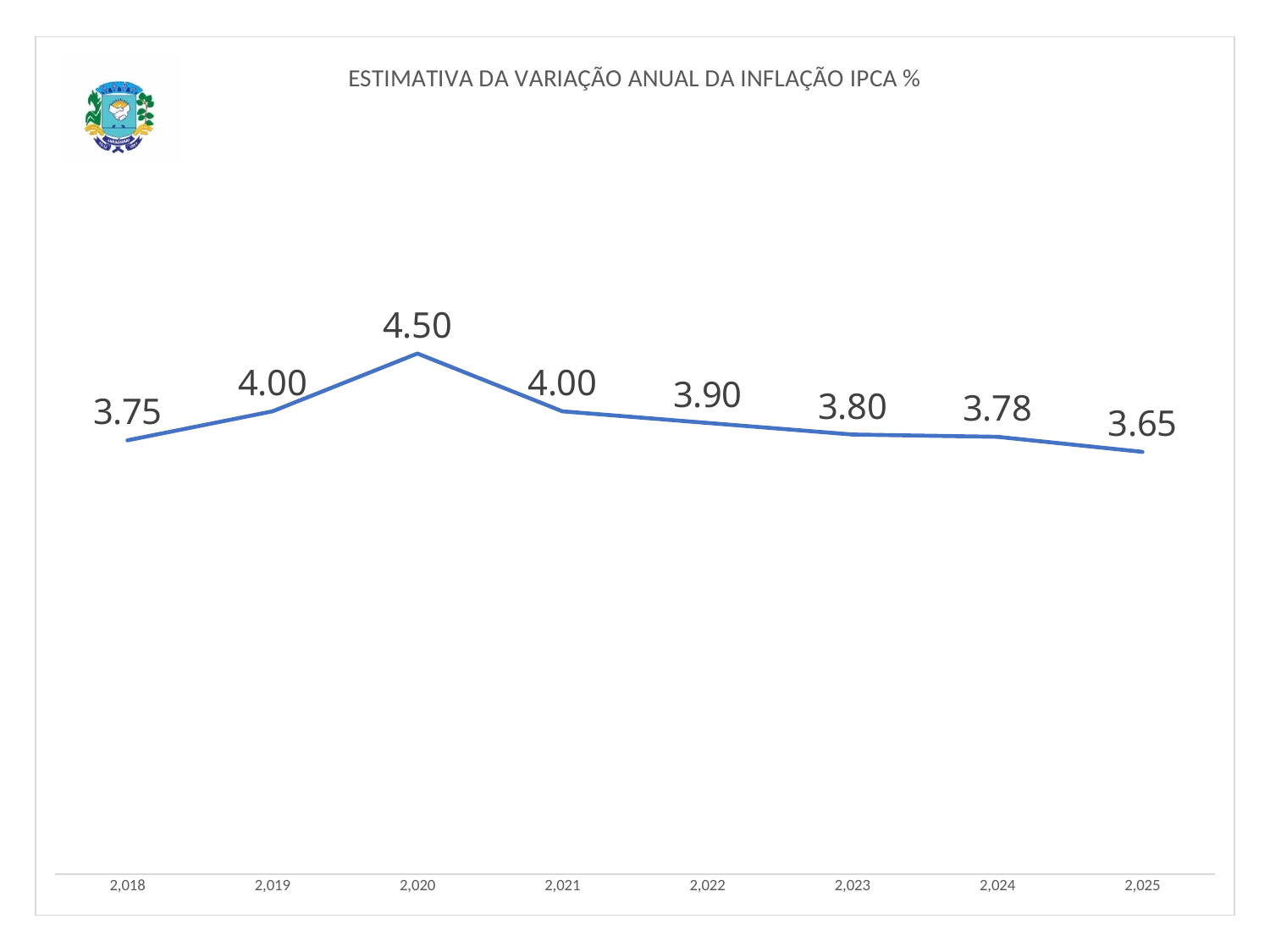
What is the estimated IPCA inflation value for 2,018? 3.75 What is the difference between the values for 2,019 and 2,018? 0.25 What is the difference between the values for 2,020 and 2,025? 0.85 How many years are plotted on the chart? 8 Do the values rise or fall from 2,020 to 2,025? Fall What is the estimated IPCA inflation value for 2,020? 4.50 Which year has the lowest estimated IPCA inflation value? 2,025 What kind of chart is shown on the slide? Line chart What is the estimated IPCA inflation value for 2,025? 3.65 Which year has a larger value, 2,022 or 2,023? 2,022 What is the estimated IPCA inflation value for 2,024? 3.78 Which year has the highest estimated IPCA inflation value? 2,020